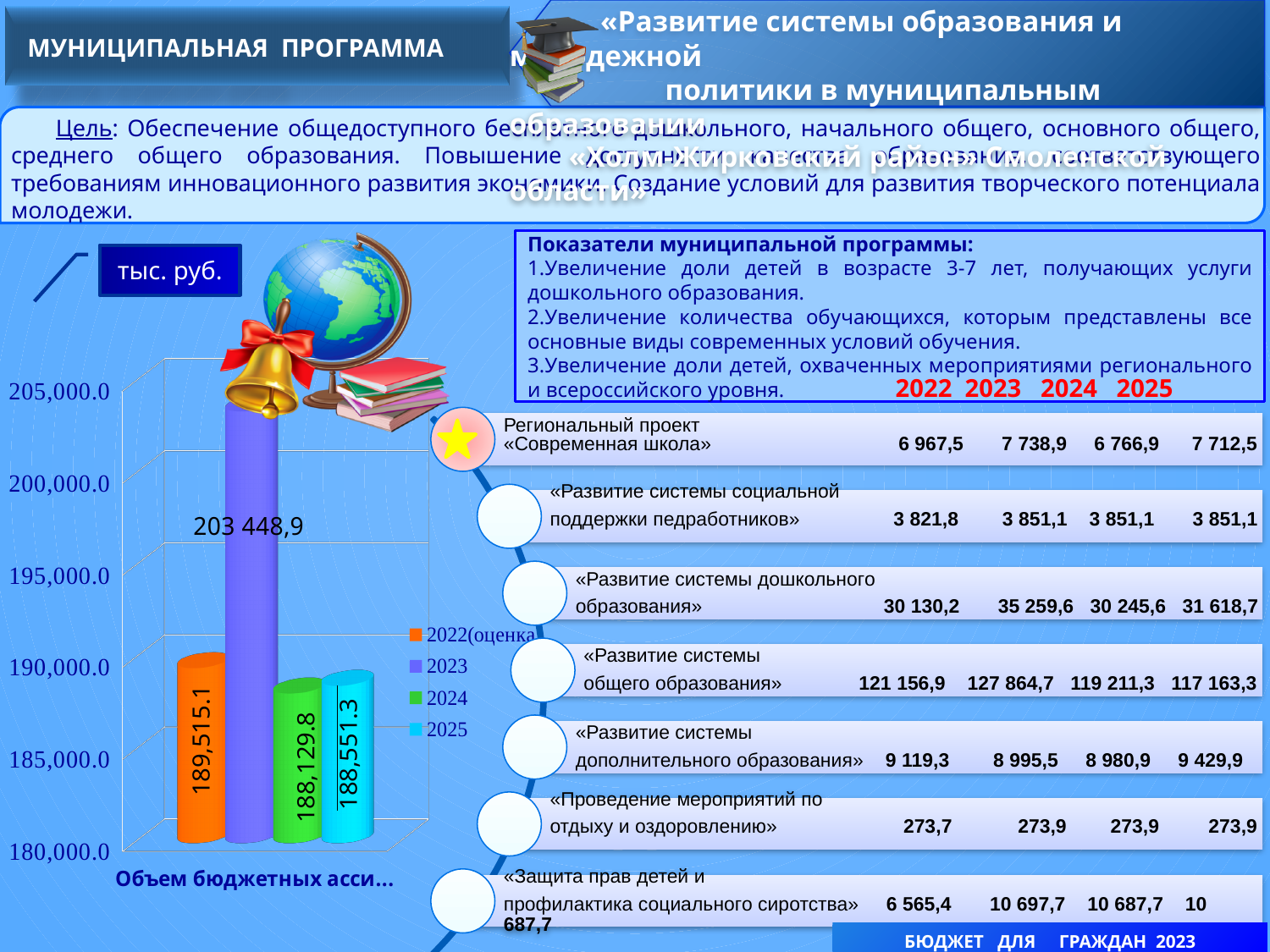
How many entries does the chart legend list? 4 What is the value of the bar for 2025? 188,551.3 Which year has the lowest bar? 2024 What is the difference between the values for 2025 and 2024? 421.5 What is the value of the bar for 2023? 203 448,9 Which is larger, the value for 2024 or the value for 2025? 2025 What is the value of the bar for 2022(оценка)? 189,515.1 What kind of chart is shown on the left of the slide? bar chart Which year has the highest bar? 2023 Is the value for 2023 greater or less than 200,000.0? greater How many bars are plotted in the chart? 4 What is the value of the bar for 2024? 188,129.8